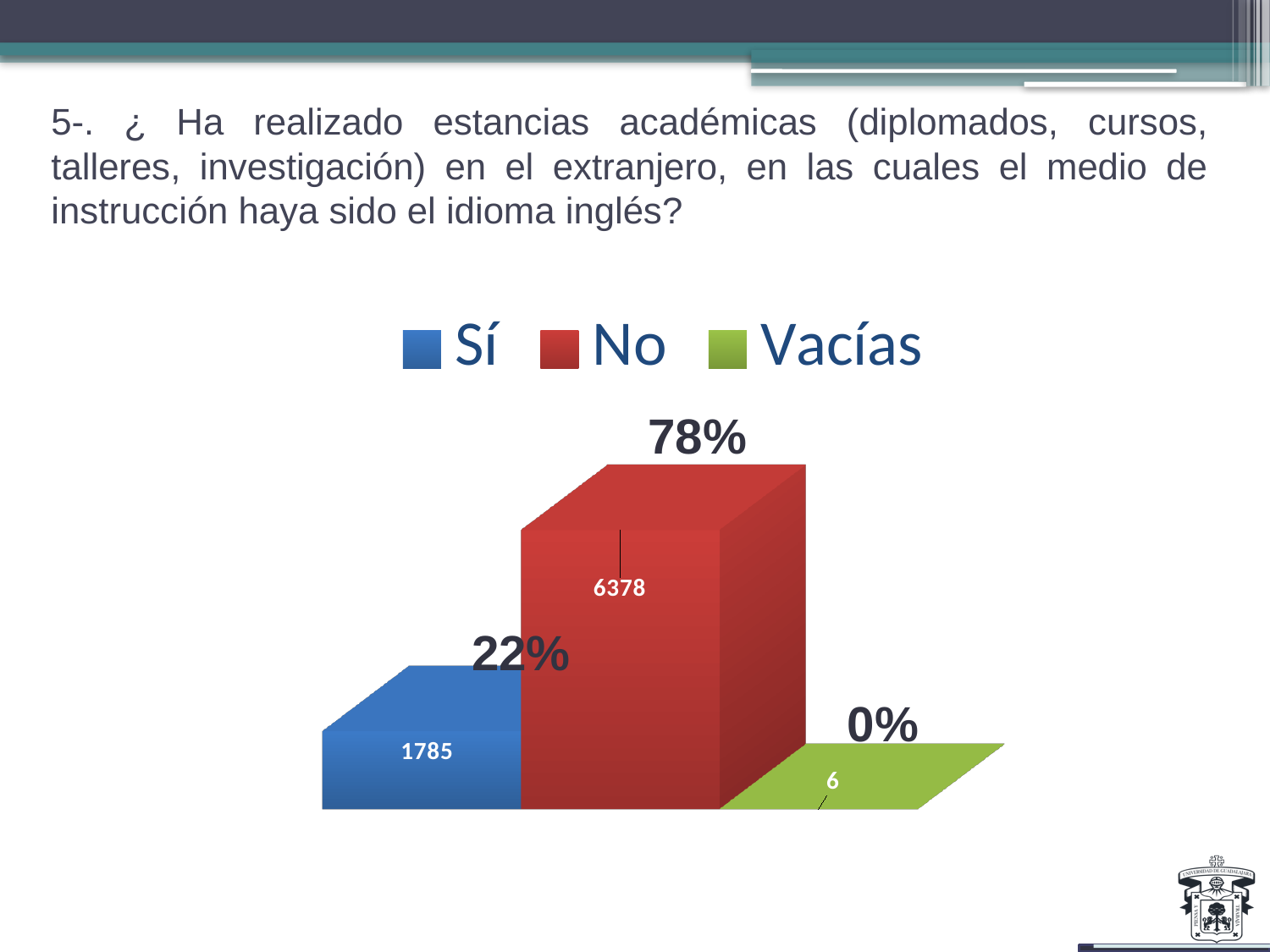
What is the value shown for No? 6378 What is the value shown for Vacías? 6 Which category has the highest value? No How many series does the legend list? 3 Which category has the lowest value? Vacías What percentage is shown above the Sí bar? 22% What is the difference between the values for No and Sí? 4593 What percentage is shown above the No bar? 78% What kind of chart is shown on the slide? Bar chart What is the value shown for Sí? 1785 What percentage is shown above the Vacías bar? 0% Which is larger, the value for Sí or the value for No? No